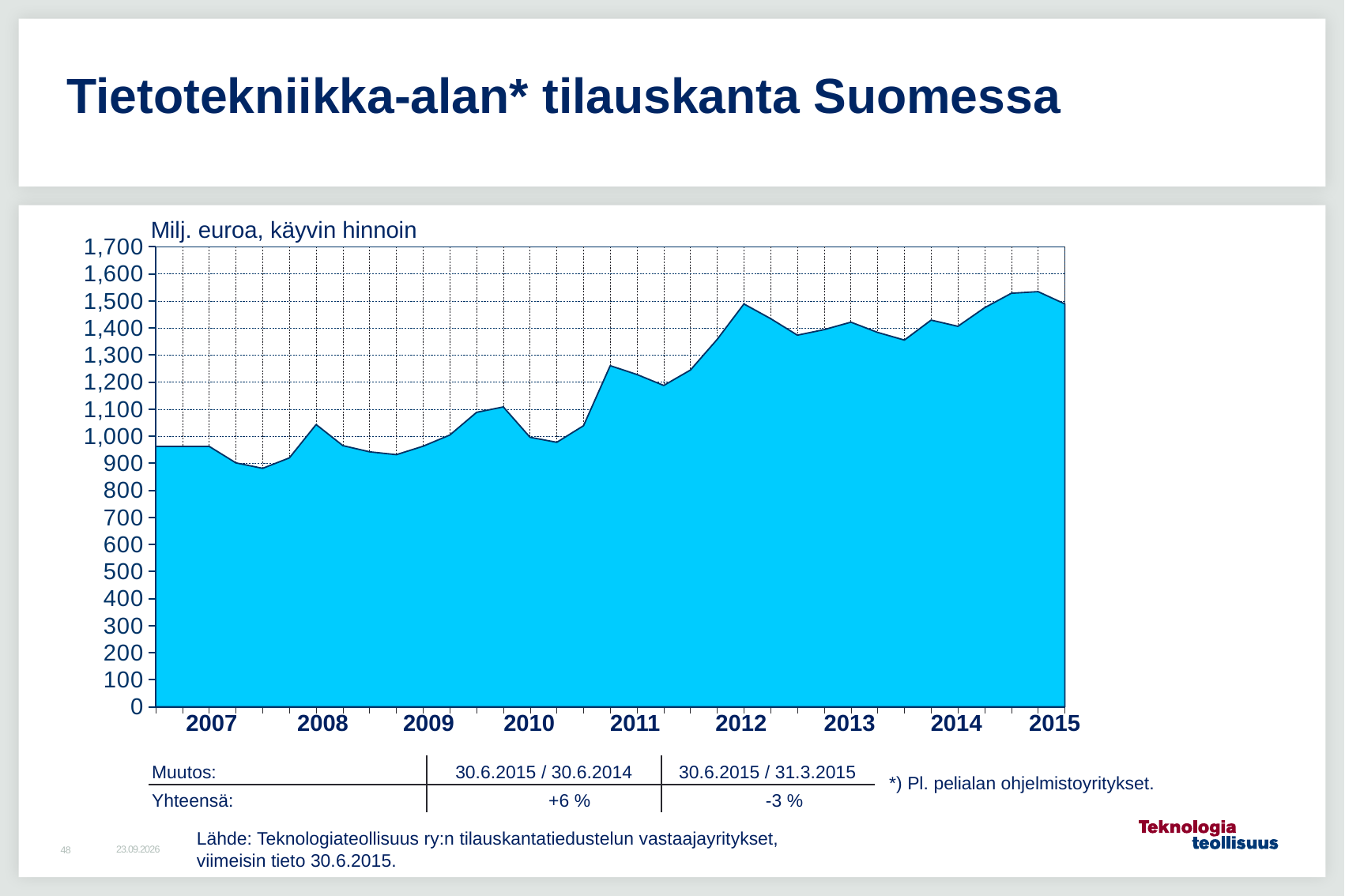
Is the value at 2011 greater or less than 1,200? greater Which is larger, the value at 2007 or the value at 2015? 2015 What is the highest value shown on the y axis of the chart? 1,700 Overall, do the values rise or fall from 2007 to 2015? rise Is the value at 2015 greater or less than 1,400? greater What kind of chart is shown on the slide? area chart Is the value at 2013 greater or less than 1,300? greater What is the unit label shown above the chart's y axis? Milj. euroa, käyvin hinnoin Which is larger, the value at 2011 or the value at 2012? 2012 How many years are labelled on the x axis of the chart? 9